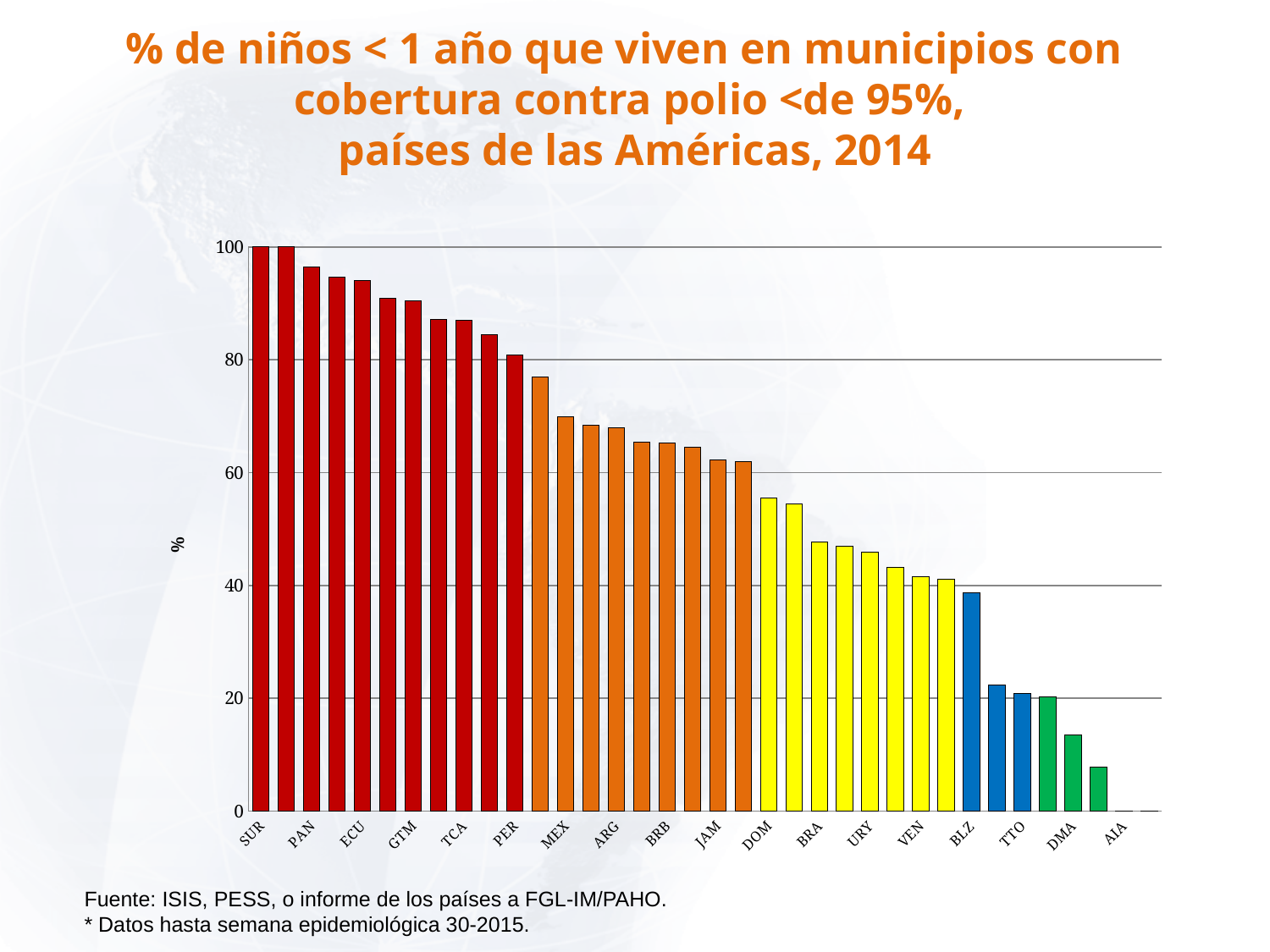
What is the value for AIA? 0 What kind of chart is shown on the slide? bar chart Is the value for PAN greater or less than 80? greater What is the label on the vertical axis of the chart? % Which is larger, the value for PAN or the value for TTO? PAN Is the value for TTO greater or less than 40? less Is the value for URY greater or less than 60? less Which country has the highest value in the chart? SUR What is the value for SUR? 100 Do the values rise or fall moving from left to right along the x axis? fall